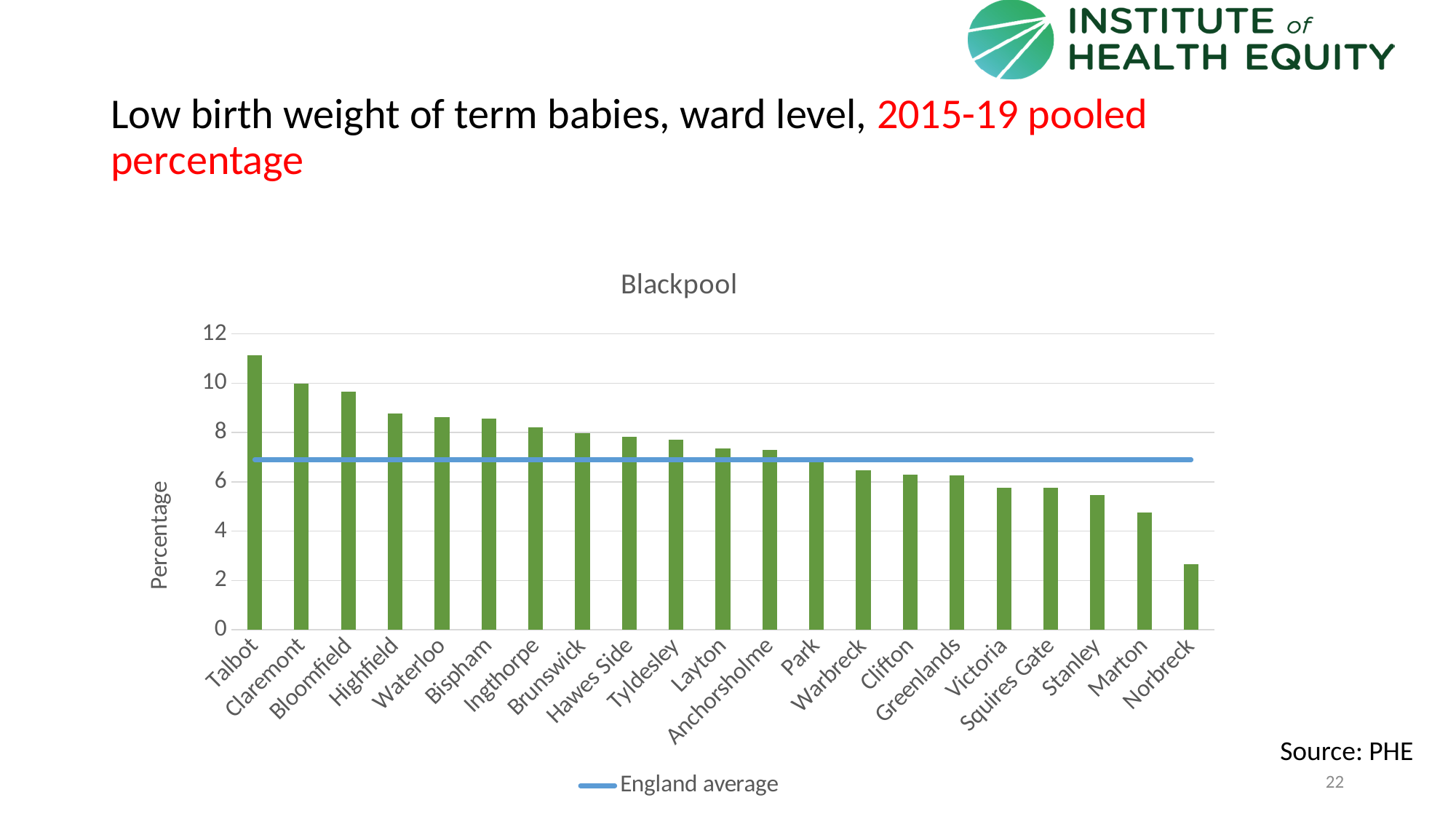
Which ward has the highest low birth weight percentage? Talbot Which is larger, the value for Highfield or the value for Stanley? Highfield How many entries does the legend list? 1 What kind of chart is shown on the slide? bar chart Is the value for Talbot greater or less than 10? greater Is the value for Marton greater or less than 6? less What is the title of the chart? Blackpool Is the value for Norbreck greater or less than 4? less Which ward has the lowest low birth weight percentage? Norbreck How many wards are shown on the x axis? 21 Do the bar values rise or fall moving from left to right along the x axis? fall